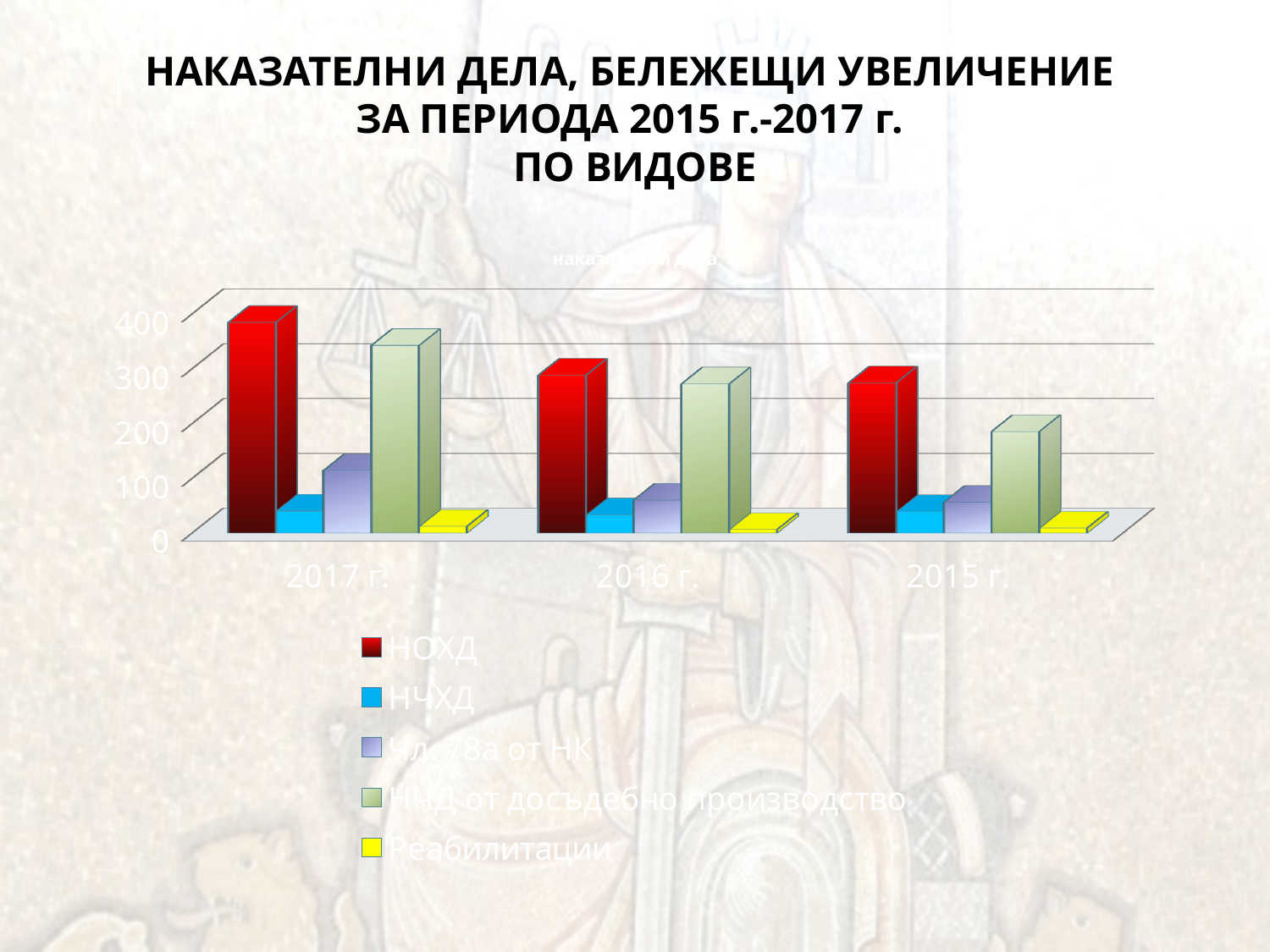
How many series does the legend list? 5 Is the value for НОХД in 2017 г. greater or less than 300? greater Is the value for НЧД от досъдебно производство in 2015 г. greater or less than 300? less What colour are the bars for the НЧХД series? blue Which is larger: НОХД in 2017 г. or НОХД in 2015 г.? НОХД in 2017 г. Which is larger: НЧД от досъдебно производство in 2017 г. or in 2015 г.? 2017 г. Which series has the shortest bar for 2016 г.? Реабилитации Do the НОХД values rise or fall moving left to right along the x axis from 2017 г. to 2015 г.? fall How many year categories are shown on the x axis? 3 Which series has the tallest bar for 2017 г.? НОХД What kind of chart is shown on the slide? bar chart Is the value for Реабилитации in 2016 г. greater or less than 100? less